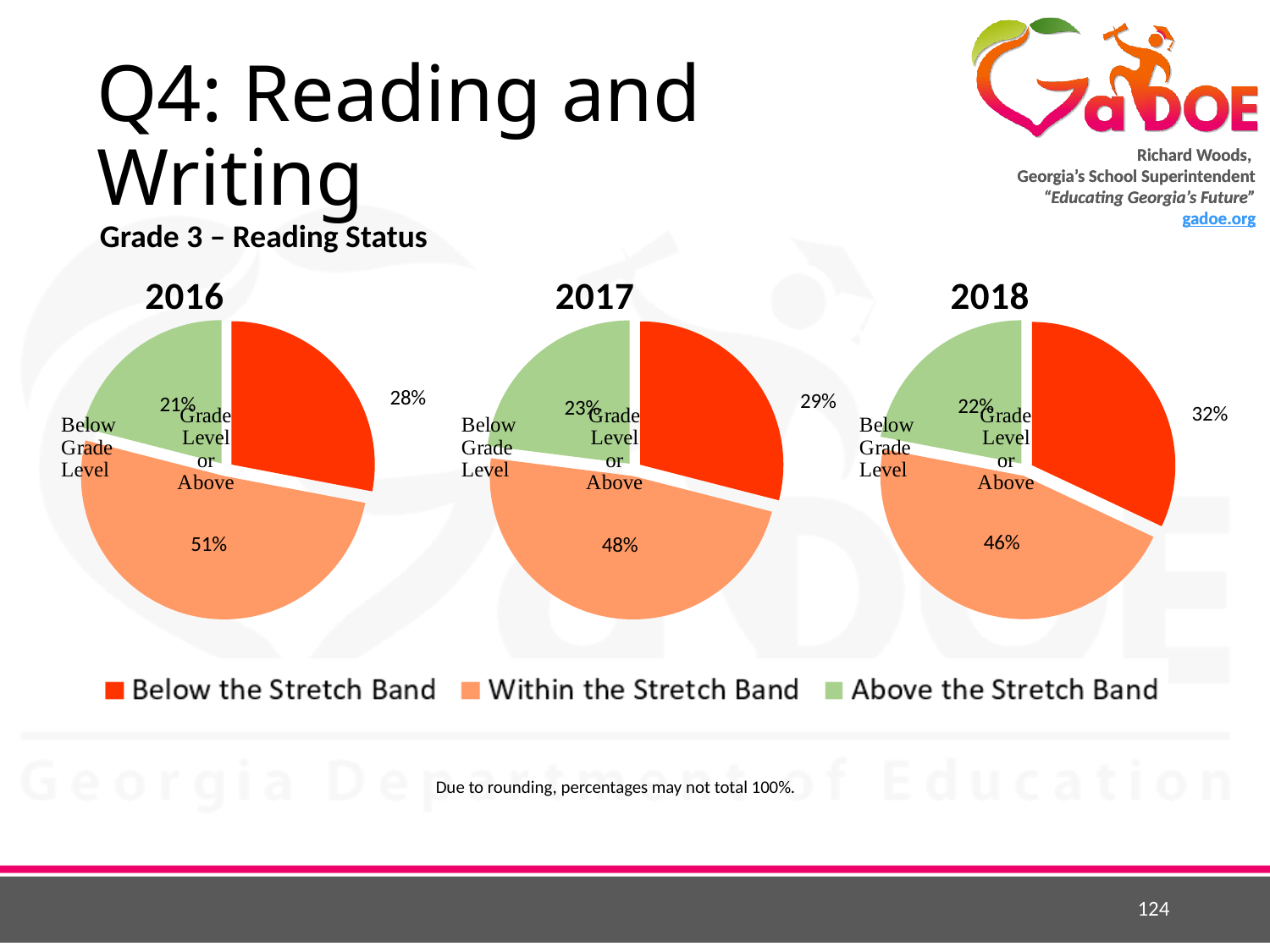
Which colour represents Above the Stretch Band in the legend? Green What kind of chart is used to show the Grade 3 Reading Status for each year? Pie chart In the 2017 pie chart, which category has the largest share? Within the Stretch Band How many pie charts are shown on the slide? 3 In the 2016 pie chart, which category has the smallest share? Above the Stretch Band In the 2016 pie chart, what percentage is Within the Stretch Band? 51% Across the 2016, 2017 and 2018 pie charts, does the Within the Stretch Band share rise or fall over the years? Fall Which is larger: the Below the Stretch Band share in 2016 or in 2018? 2018 How many categories does the legend list for these pie charts? 3 In the 2017 pie chart, what percentage is Above the Stretch Band? 23% In the 2018 pie chart, what is the difference between the Within the Stretch Band share and the Below the Stretch Band share? 14% In the 2018 pie chart, what percentage is Below the Stretch Band? 32%